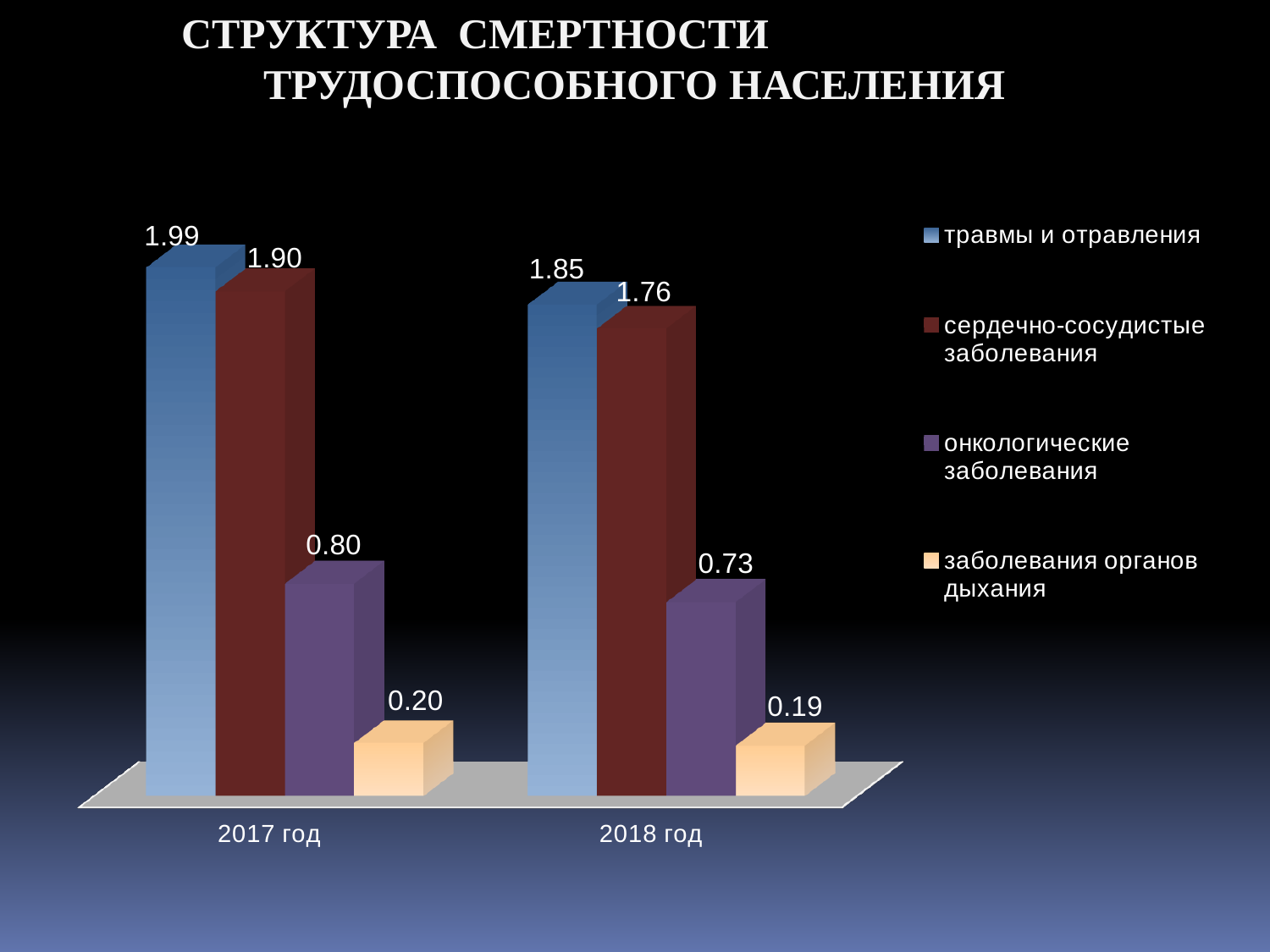
What is the value for сердечно-сосудистые заболевания in 2018 год? 1.76 How many series does the legend list? 4 What is the value for заболевания органов дыхания in 2018 год? 0.19 How many categories are shown on the x axis? 2 What is the value for травмы и отравления in 2017 год? 1.99 What is the difference between сердечно-сосудистые заболевания and онкологические заболевания in 2017 год? 1.10 Which series has the highest value in 2018 год? травмы и отравления What kind of chart is shown on the slide? bar chart Which is larger: онкологические заболевания in 2017 год or in 2018 год? 2017 год What is the difference between the values for травмы и отравления in 2017 год and 2018 год? 0.14 What is the value for онкологические заболевания in 2017 год? 0.80 Which series has the lowest value in 2017 год? заболевания органов дыхания